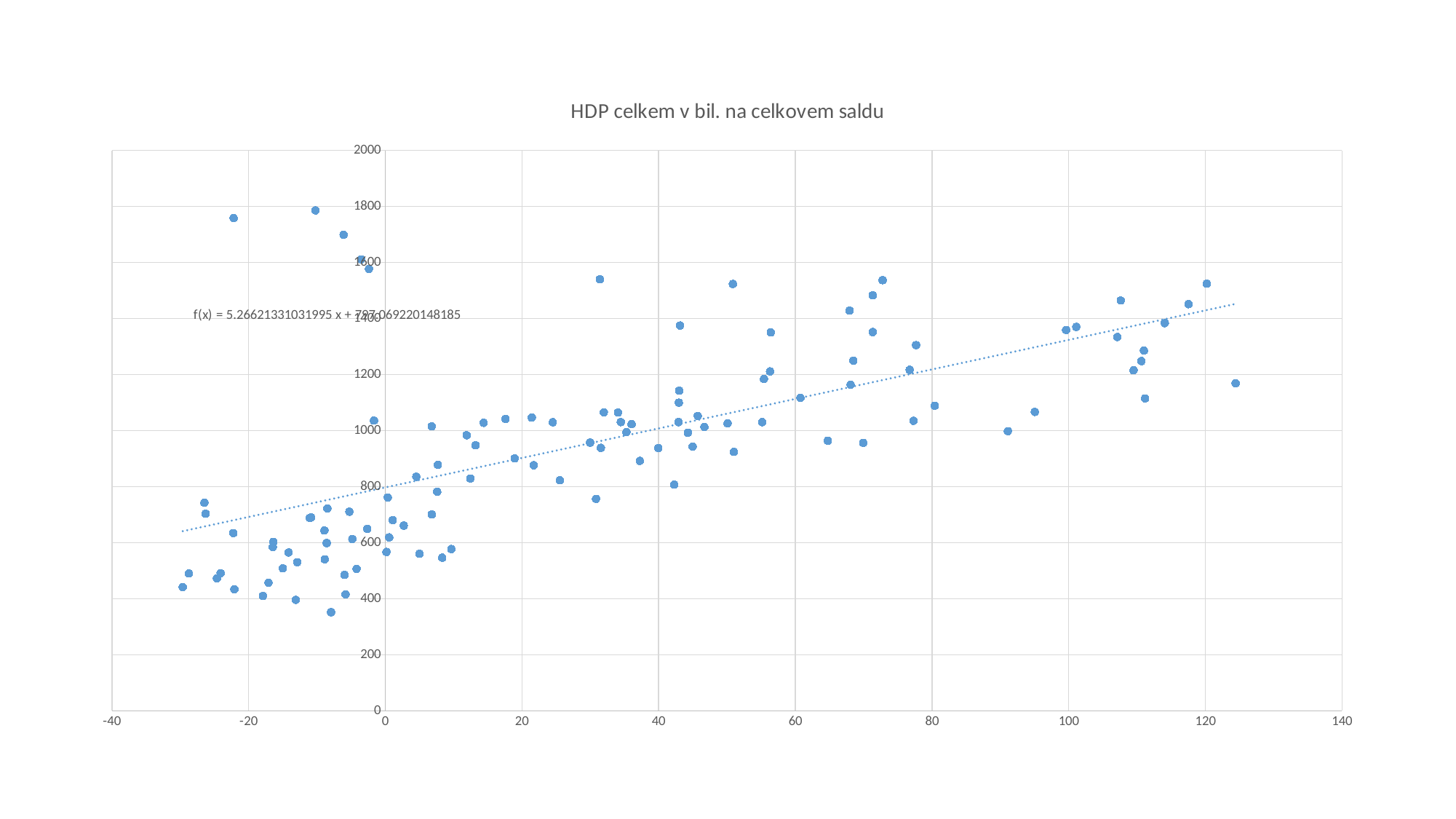
What is the title of the chart? HDP celkem v bil. na celkovem saldu Is the y value of the lowest point on the chart greater or less than 400? less Do the plotted values generally rise or fall as the x value increases? rise Is the y value of the highest point on the chart greater or less than 1600? greater Does the dotted trendline slope upward or downward from left to right? upward What is the slope coefficient shown in the trendline equation f(x)? 5.26621331031995 Is the y value of the leftmost point (near x = -30) greater or less than 600? less What kind of chart is shown on the slide? scatter chart